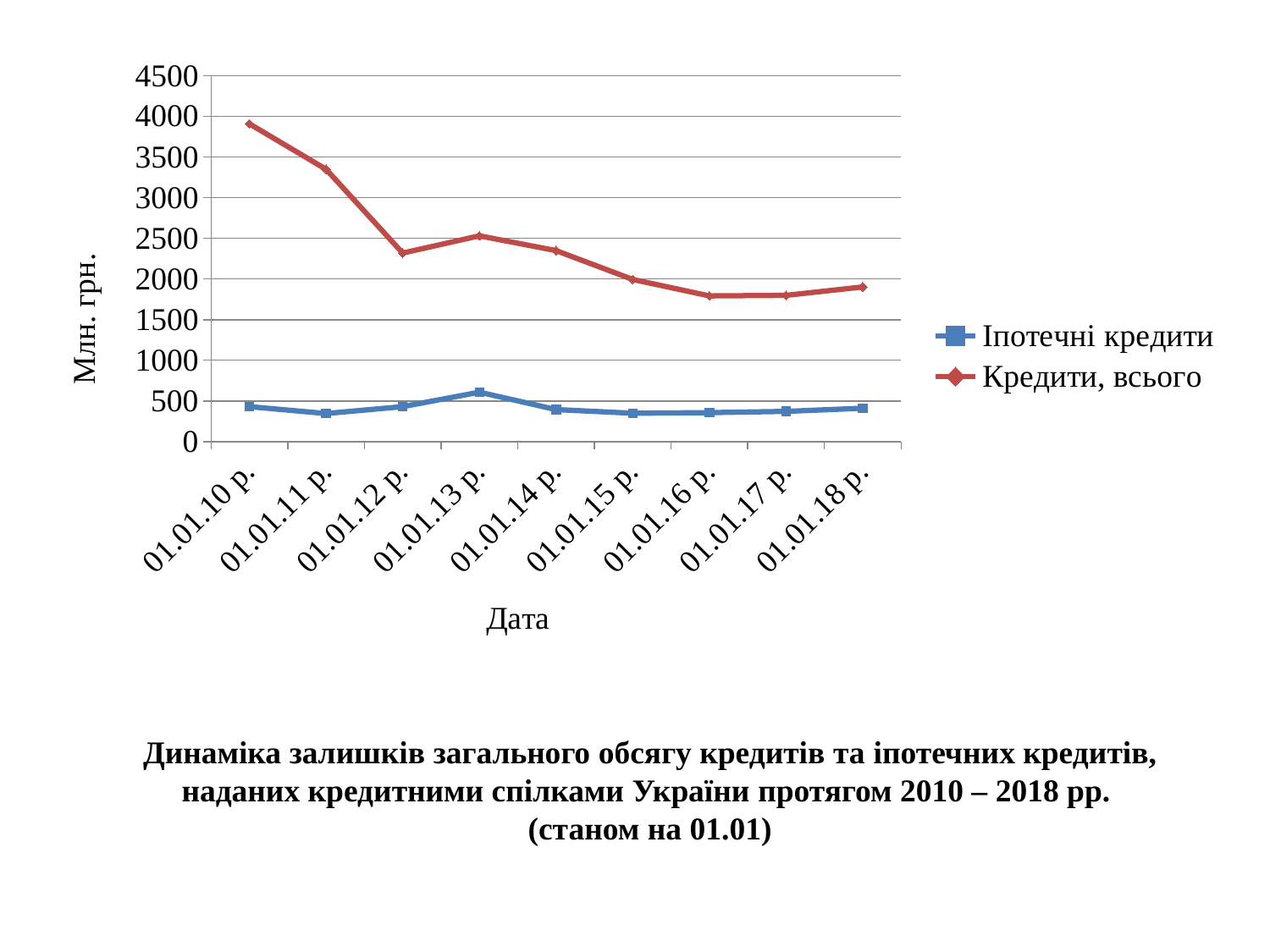
How many series does the legend list? 2 At which date is the value for "Кредити, всього" highest? 01.01.10 р. Is the value for "Кредити, всього" at 01.01.18 р. greater or less than 2000? less Does the value for "Кредити, всього" generally rise or fall from 01.01.10 р. to 01.01.18 р.? fall Is the value for "Кредити, всього" at 01.01.12 р. greater or less than 2500? less How many dates are plotted along the x axis? 9 At which date is the value for "Іпотечні кредити" highest? 01.01.13 р. What is the label of the vertical axis? Млн. грн. Which series has the larger value at 01.01.15 р., "Іпотечні кредити" or "Кредити, всього"? Кредити, всього What kind of chart is shown on the slide? line chart Is the value for "Кредити, всього" at 01.01.10 р. greater or less than 3500? greater